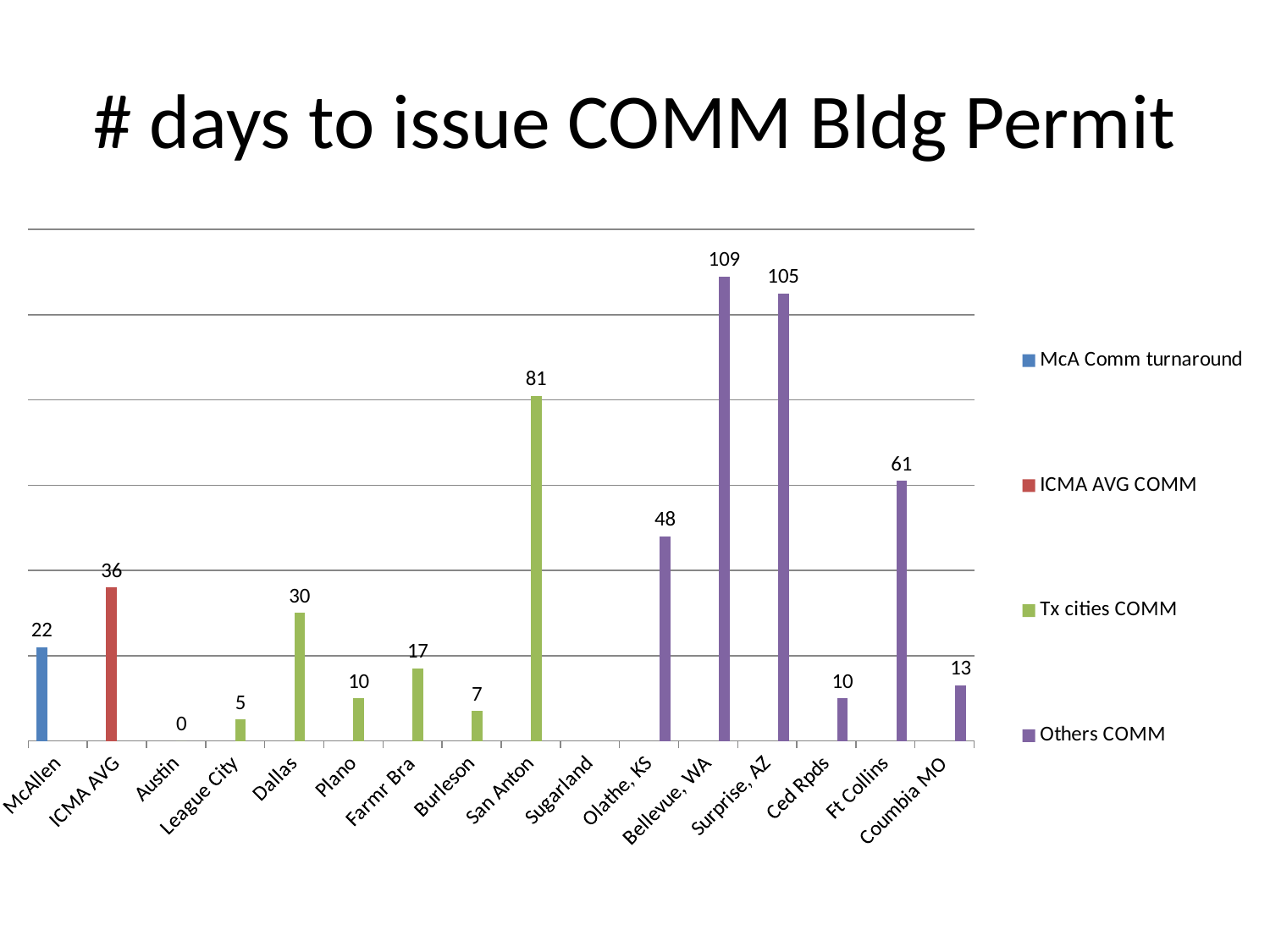
What is the title of the chart? # days to issue COMM Bldg Permit How many series does the legend list? 4 What is the value for ICMA AVG? 36 What is the value for Bellevue, WA? 109 Which is larger, the value for Dallas or the value for Farmr Bra? Dallas What kind of chart is shown on the slide? Bar chart What is the value for McAllen? 22 What is the difference between the values for Bellevue, WA and Surprise, AZ? 4 What is the difference between the values for ICMA AVG and McAllen? 14 Which is larger, the value for Ft Collins or the value for Olathe, KS? Ft Collins Which category has the highest value? Bellevue, WA What is the value for San Anton? 81